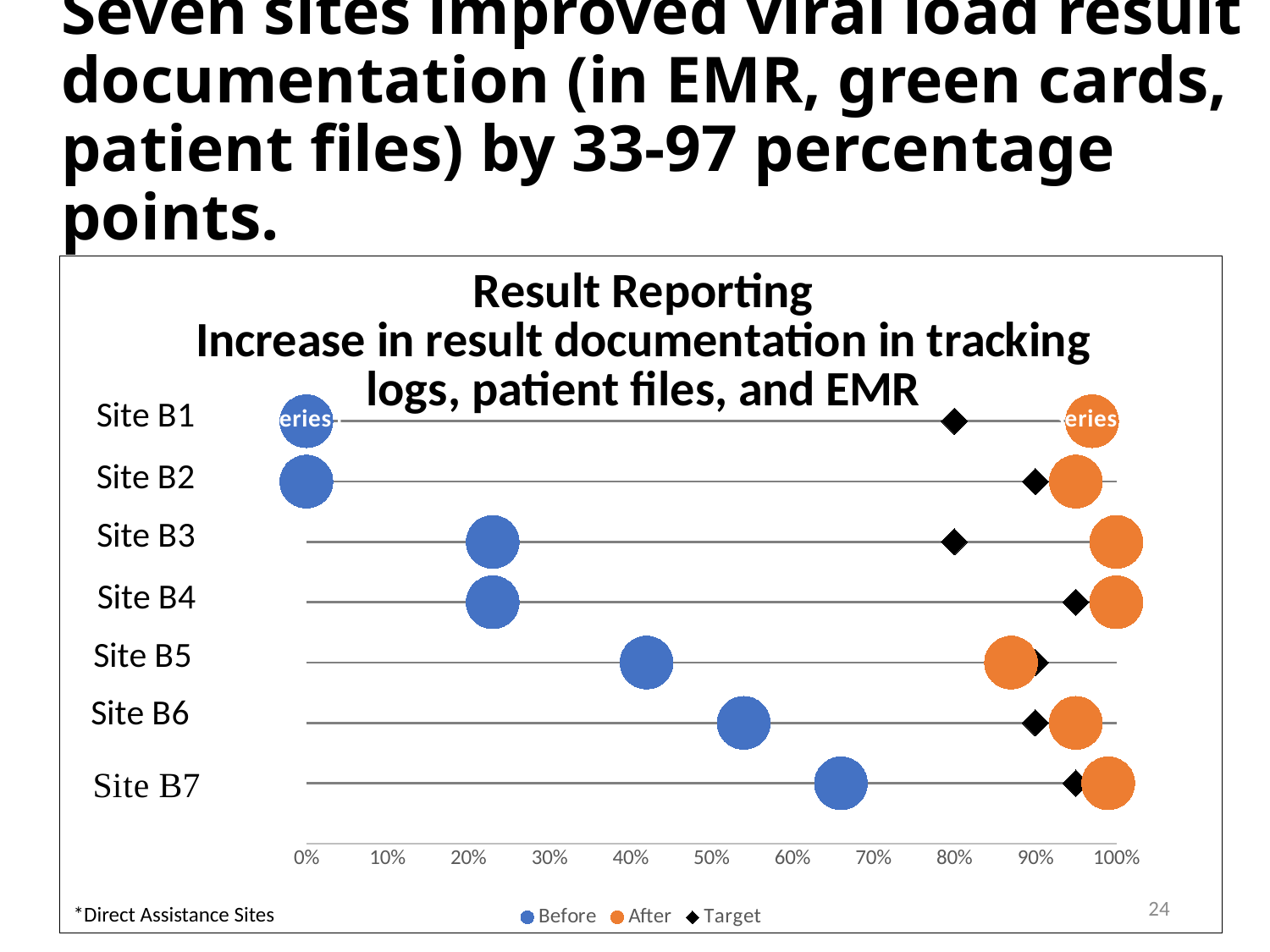
What kind of chart is shown on the slide? dot plot Which is larger, the Before value for Site B6 or the Before value for Site B5? Site B6 Which site has the highest Before value? Site B7 Is the Before value for Site B7 greater or less than 60%? greater How many series does the legend list? 3 Which site has the lowest After value? Site B5 Is the Before value for Site B3 greater or less than 30%? less What is the Target value for Site B1? 80% How many sites are plotted on the chart? 7 What is the Target value for Site B3? 80% What is the Before value for Site B1? 0%